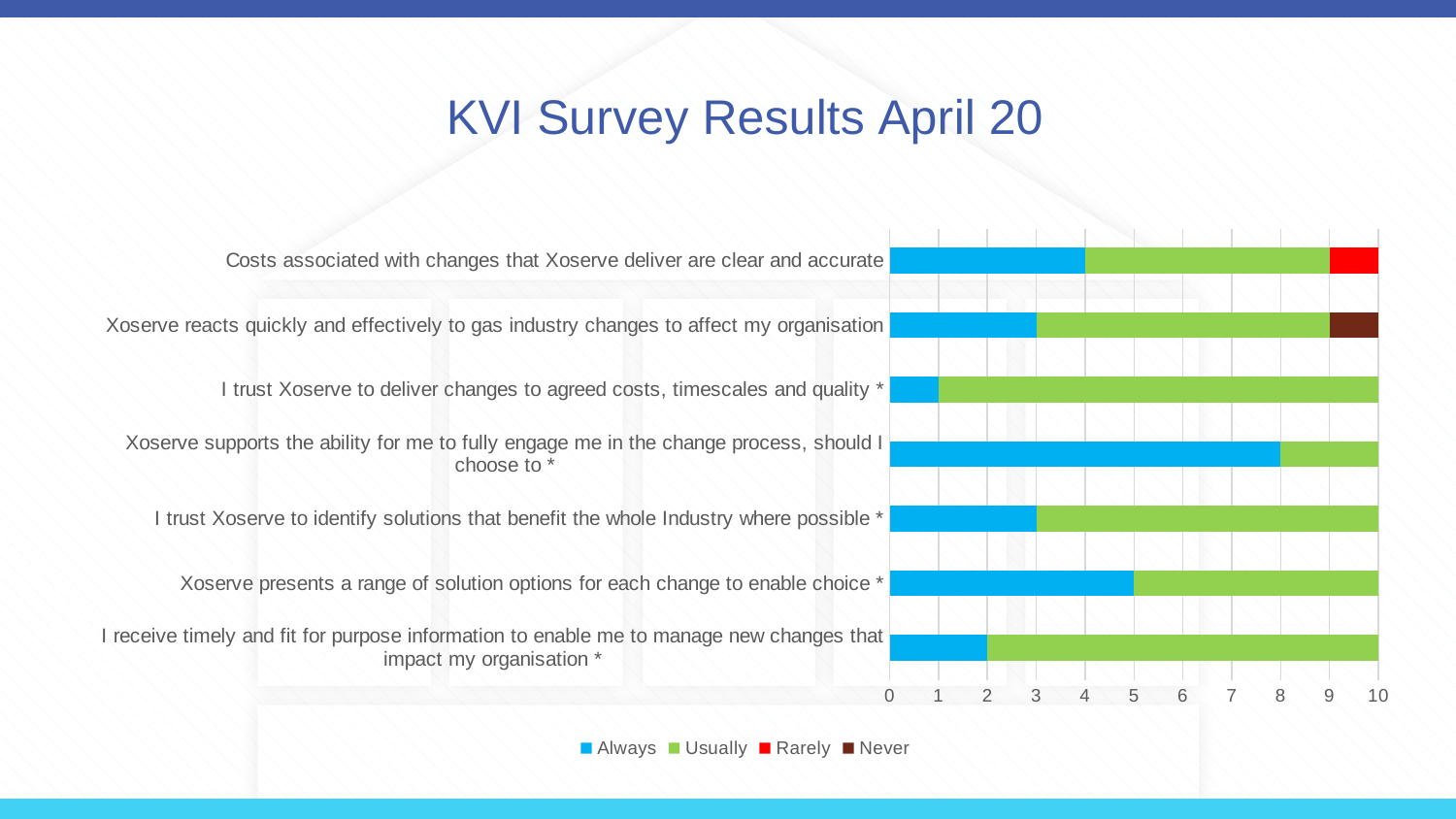
What kind of chart is shown on the slide? Stacked bar chart Which statement has the highest Always value? Xoserve supports the ability for me to fully engage me in the change process, should I choose to Which statement has the lowest Always value? I trust Xoserve to deliver changes to agreed costs, timescales and quality What is the Always value for "Xoserve presents a range of solution options for each change to enable choice"? 5 Which statement is the only one with a Never segment? Xoserve reacts quickly and effectively to gas industry changes to affect my organisation What is the total of the stacked bar for "I trust Xoserve to identify solutions that benefit the whole Industry where possible"? 10 Which has the larger Always value: "Xoserve presents a range of solution options for each change to enable choice" or "I receive timely and fit for purpose information to enable me to manage new changes that impact my organisation"? Xoserve presents a range of solution options for each change to enable choice What is the Always value for "Xoserve supports the ability for me to fully engage me in the change process, should I choose to"? 8 How many survey statements are plotted on the chart? 7 What is the difference between the Always values for "Xoserve supports the ability for me to fully engage me in the change process, should I choose to" and "I receive timely and fit for purpose information to enable me to manage new changes that impact my organisation"? 6 How many series does the legend list? 4 Is the Always value for "Costs associated with changes that Xoserve deliver are clear and accurate" greater or less than 5? less